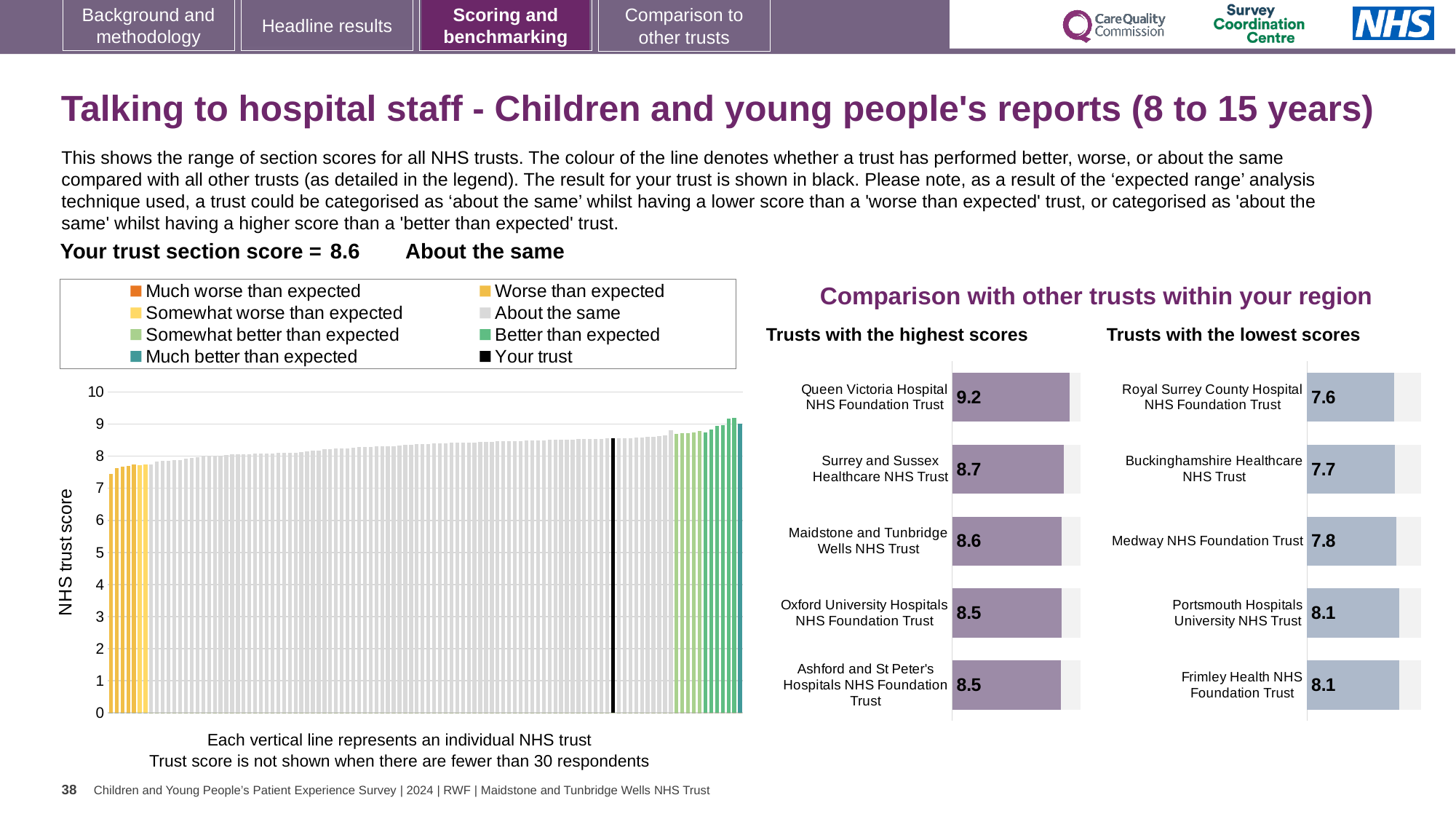
In the 'Trusts with the lowest scores' chart, what is the difference between the scores of Frimley Health NHS Foundation Trust and Royal Surrey County Hospital NHS Foundation Trust? 0.5 In the 'Trusts with the lowest scores' chart, which trust has the lowest score? Royal Surrey County Hospital NHS Foundation Trust In the 'Trusts with the highest scores' chart, which trust has the highest score? Queen Victoria Hospital NHS Foundation Trust How many entries does the legend of the large chart on the left list? 8 In the 'Trusts with the lowest scores' chart, what is the score for Medway NHS Foundation Trust? 7.8 What is the y-axis label of the large chart on the left? NHS trust score In the 'Trusts with the highest scores' chart, what is the difference between the scores of Queen Victoria Hospital NHS Foundation Trust and Maidstone and Tunbridge Wells NHS Trust? 0.6 How many trusts are listed in the 'Trusts with the highest scores' chart? 5 In the 'Trusts with the lowest scores' chart, which has the larger score: Medway NHS Foundation Trust or Buckinghamshire Healthcare NHS Trust? Medway NHS Foundation Trust In the large chart on the left, is the value for the black 'Your trust' bar greater or less than 8? greater What kind of chart is the large chart on the left with the 'NHS trust score' axis? Bar chart In the 'Trusts with the highest scores' chart, what is the score for Queen Victoria Hospital NHS Foundation Trust? 9.2